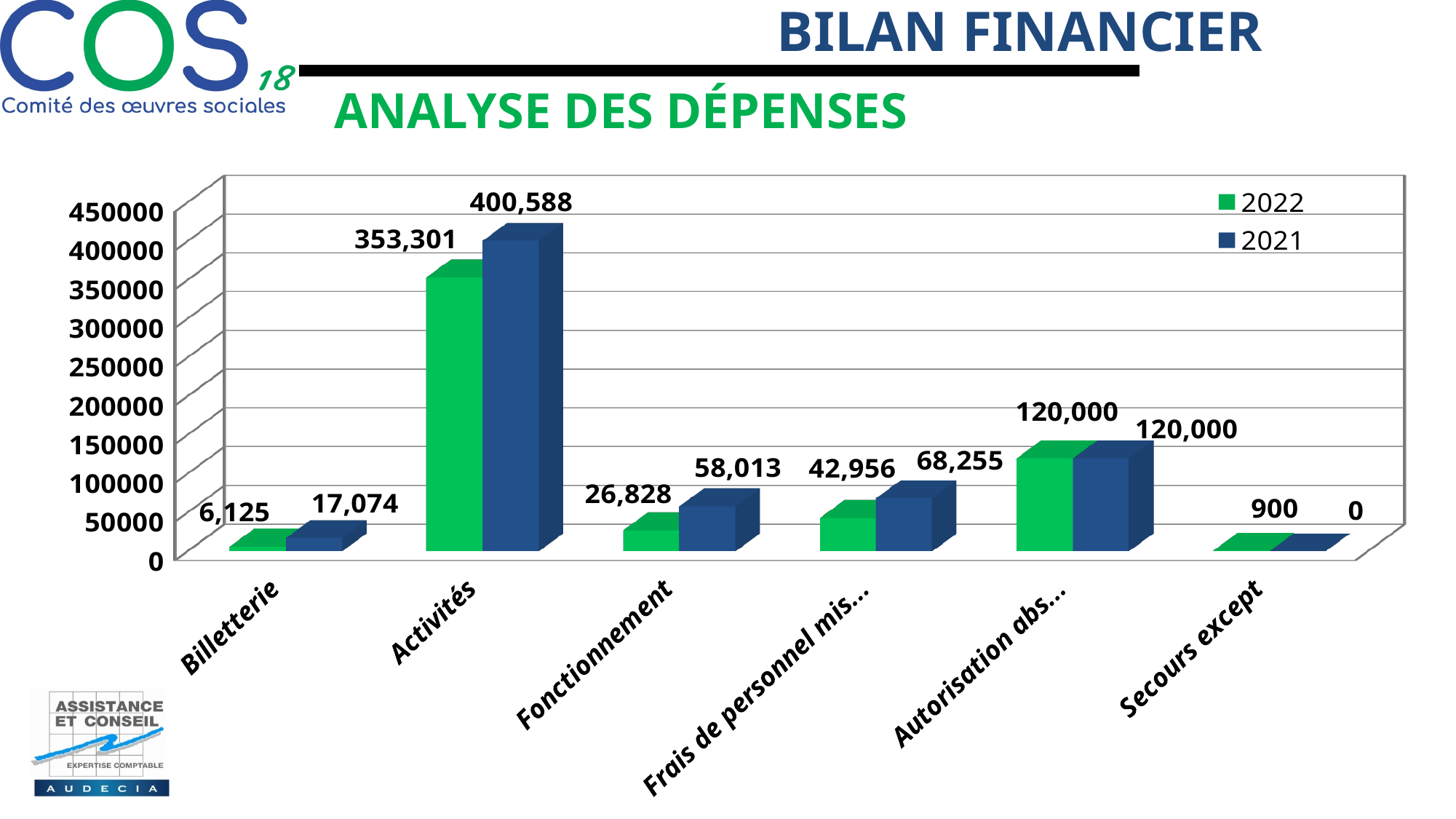
Which colour represents the 2022 series in the legend? Green How many series does the legend list? 2 How many categories are shown on the x axis? 6 Which is larger for Fonctionnement, the 2022 value or the 2021 value? 2021 What is the 2022 value for Activités? 353,301 What is the 2021 value for Fonctionnement? 58,013 Which category has the lowest 2022 value? Secours except What type of chart is shown on the slide? Bar chart What is the 2021 value for Secours except? 0 What is the 2022 value for Billetterie? 6,125 Which category has the highest 2021 value? Activités What is the difference between the 2021 and 2022 values for Activités? 47,287